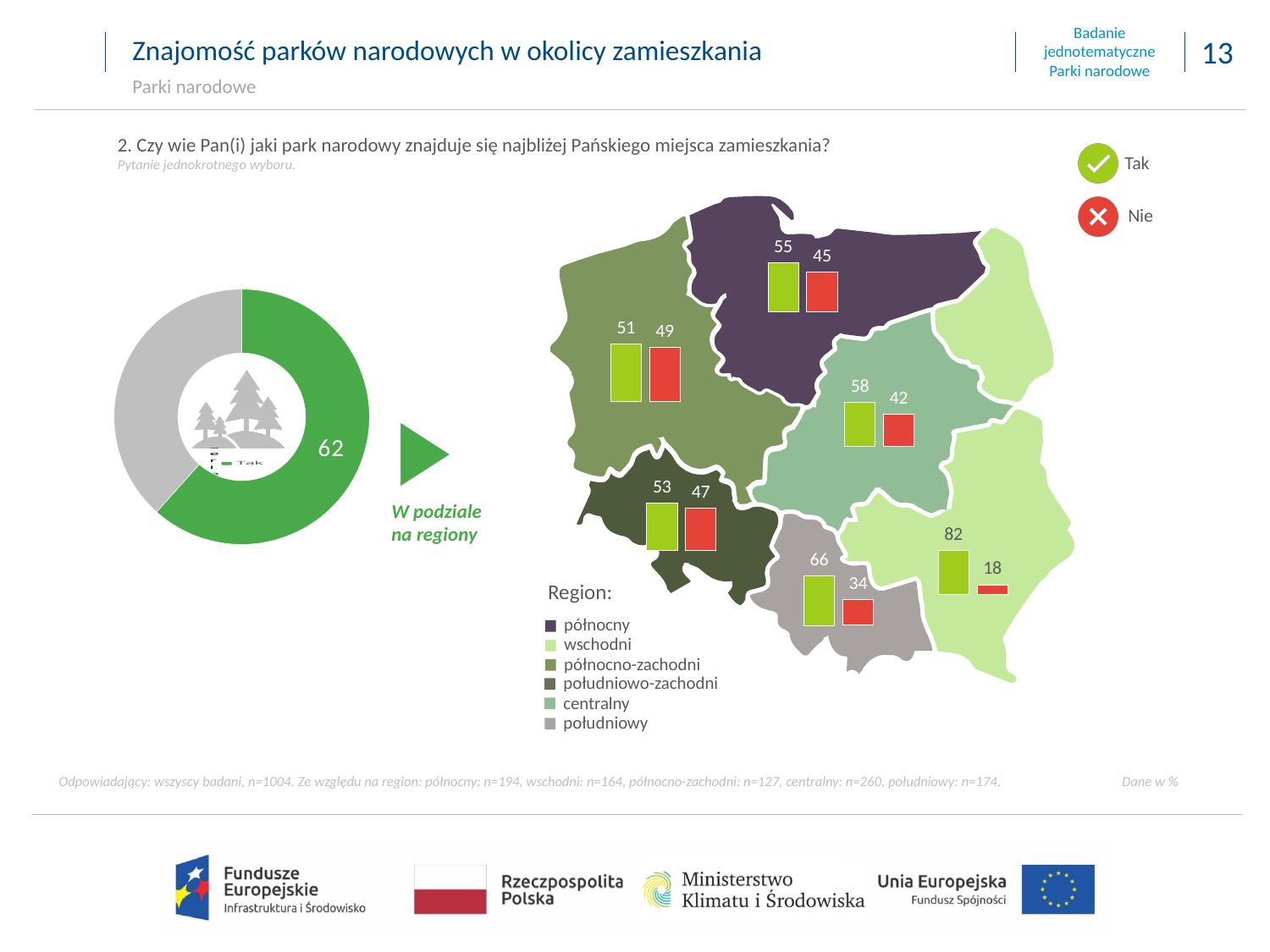
How many answer categories (Tak/Nie) does the legend in the top right list? 2 What kind of chart is the chart on the left of the slide? Donut (pie) chart On the map, what is the 'Tak' value for the północny region? 55 On the map, what is the 'Nie' value for the południowy region? 34 On the map, which region has a larger 'Tak' value: południowy or południowo-zachodni? południowy How many regions are listed in the 'Region:' legend on the map? 6 On the map, which region has the lowest 'Tak' value? północno-zachodni On the map, what is the 'Tak' value for the centralny region? 58 In the donut chart on the left, what value is shown for the green 'Tak' segment? 62 On the map, what is the 'Nie' value for the wschodni region? 18 On the map, which region has the highest 'Tak' value? wschodni On the map, what is the difference between the 'Tak' and 'Nie' values for the wschodni region? 64